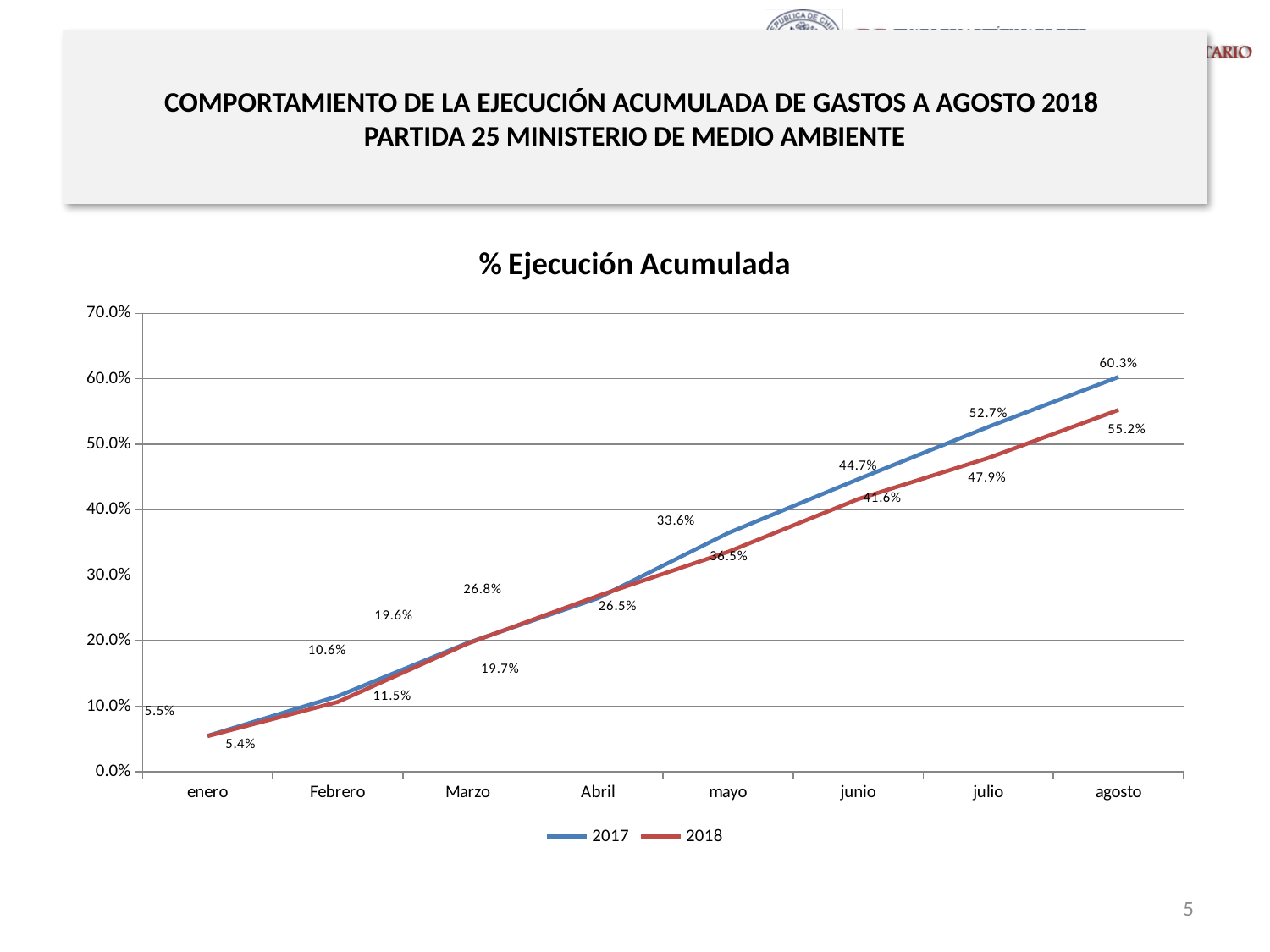
What is the value for 2017 in agosto? 60.3% What kind of chart is shown on the slide? line chart What is the value for 2017 in mayo? 36.5% How many series does the legend list? 2 What is the title of the chart? % Ejecución Acumulada How many months are plotted along the x axis? 8 In which month does the 2017 series reach its highest value? agosto What is the value for 2018 in agosto? 55.2% What is the difference between the 2017 and 2018 values in agosto? 5.1 percentage points What is the value for 2018 in julio? 47.9% Which series has the larger value in julio, 2017 or 2018? 2017 Do the values for 2018 rise or fall from enero to agosto? rise